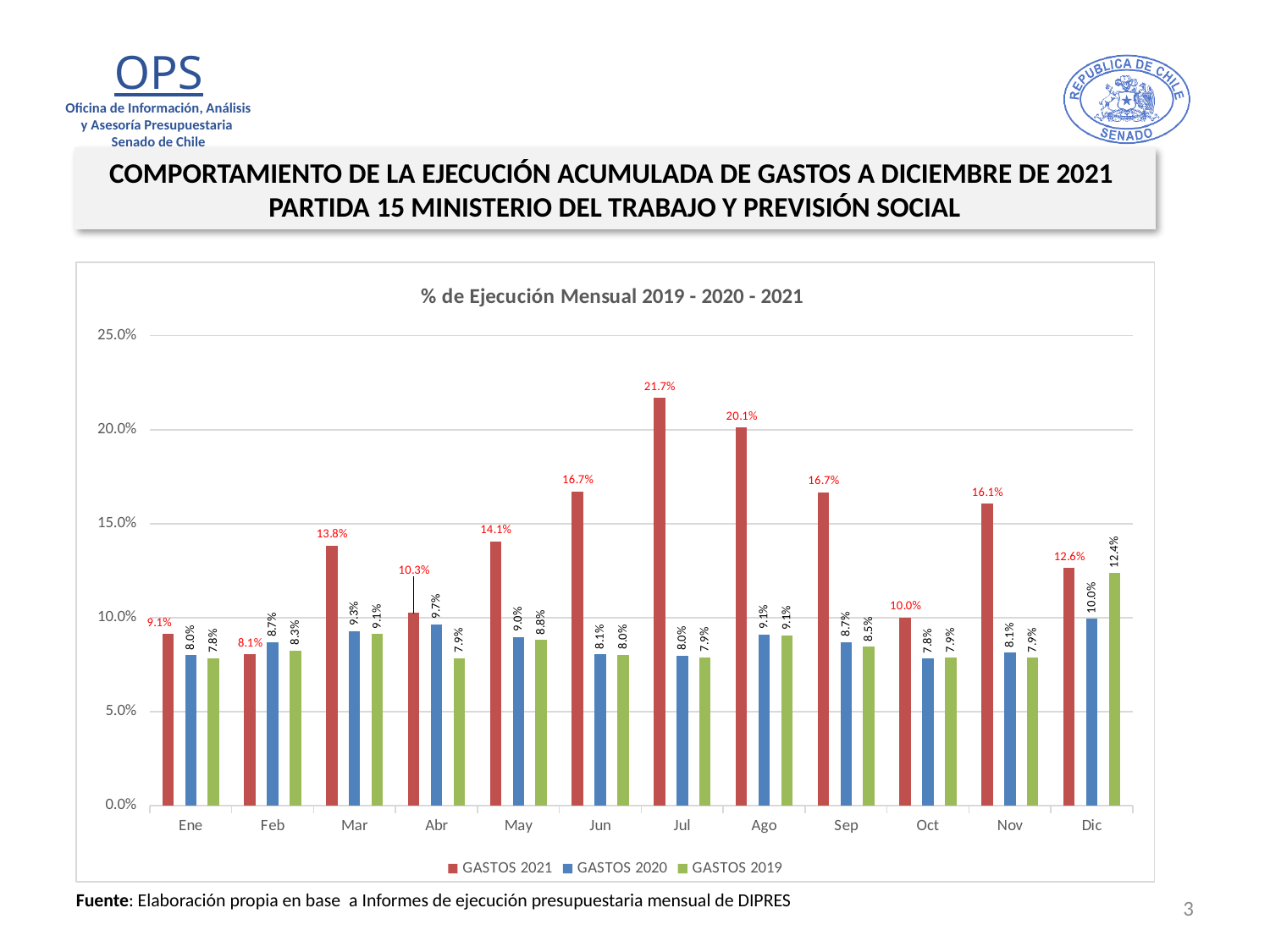
Which is larger in Feb: GASTOS 2021 or GASTOS 2020? GASTOS 2020 What is the value for GASTOS 2019 in Mar? 9.1% What kind of chart is shown on the slide? Bar chart What is the value for GASTOS 2020 in Dic? 10.0% How many series does the legend list? 3 In which month is the GASTOS 2021 value lowest? Feb Is the value for GASTOS 2021 in Ago greater or less than 15.0%? greater In which month is the GASTOS 2021 value highest? Jul What is the value for GASTOS 2021 in Jul? 21.7% What is the difference between the GASTOS 2021 value in Jul and the GASTOS 2021 value in Ago? 1.6% What is the title of the chart? % de Ejecución Mensual 2019 - 2020 - 2021 How many months are shown on the x axis? 12